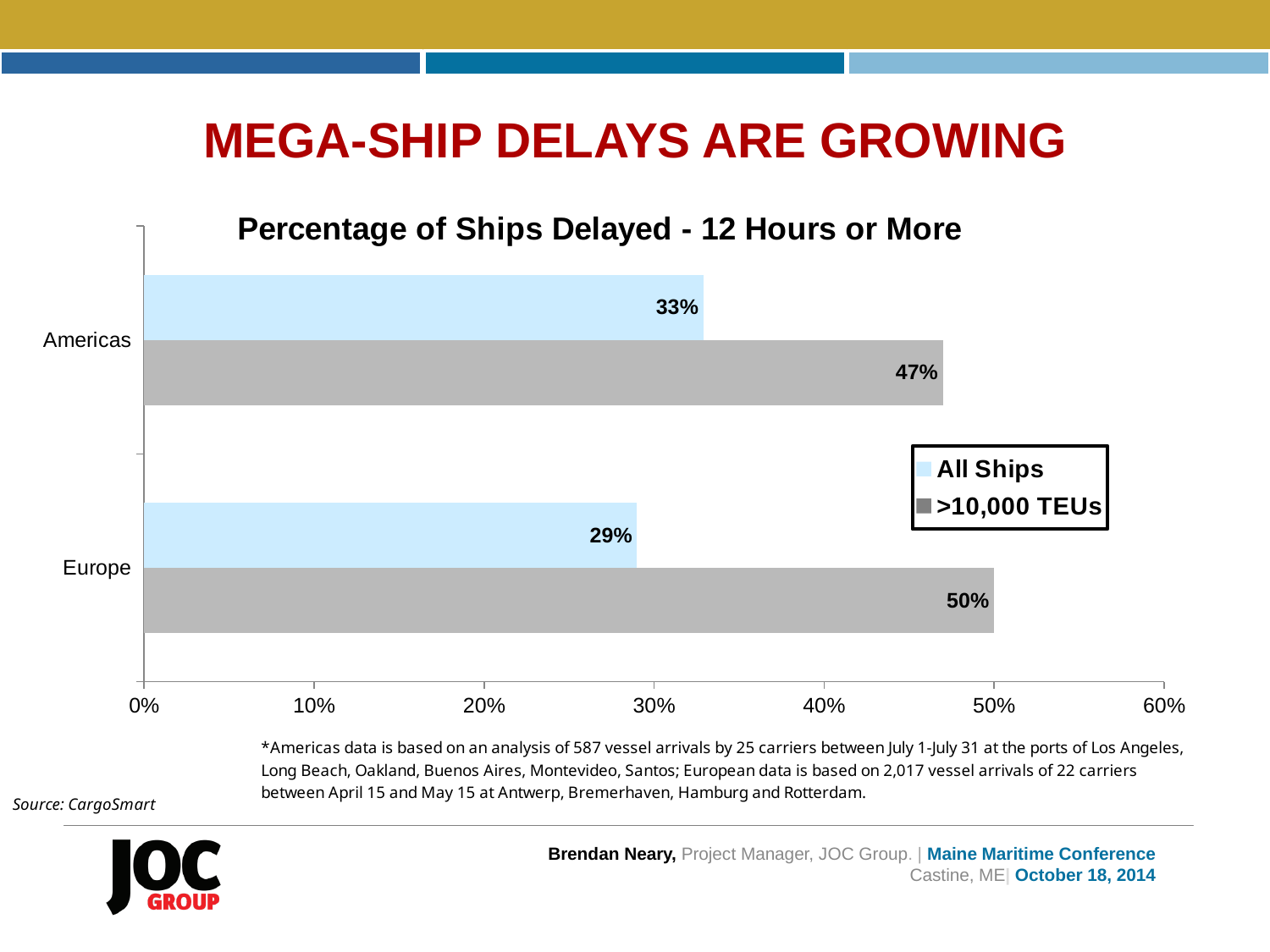
What is the title of the chart? Percentage of Ships Delayed - 12 Hours or More Which region has the lower percentage of All Ships delayed? Europe What percentage of ships over 10,000 TEUs were delayed 12 hours or more in Europe? 50% What is the difference between the >10,000 TEUs and All Ships values for Europe? 21% What is the difference between the >10,000 TEUs and All Ships values for the Americas? 14% What percentage of all ships were delayed 12 hours or more in the Americas? 33% Which region has the higher percentage of >10,000 TEU ships delayed? Europe How many series does the legend list? 2 What kind of chart is shown on the slide? Bar chart How many regions are shown on the chart? 2 What is the value for >10,000 TEUs in the Americas? 47% What is the value for All Ships in Europe? 29%